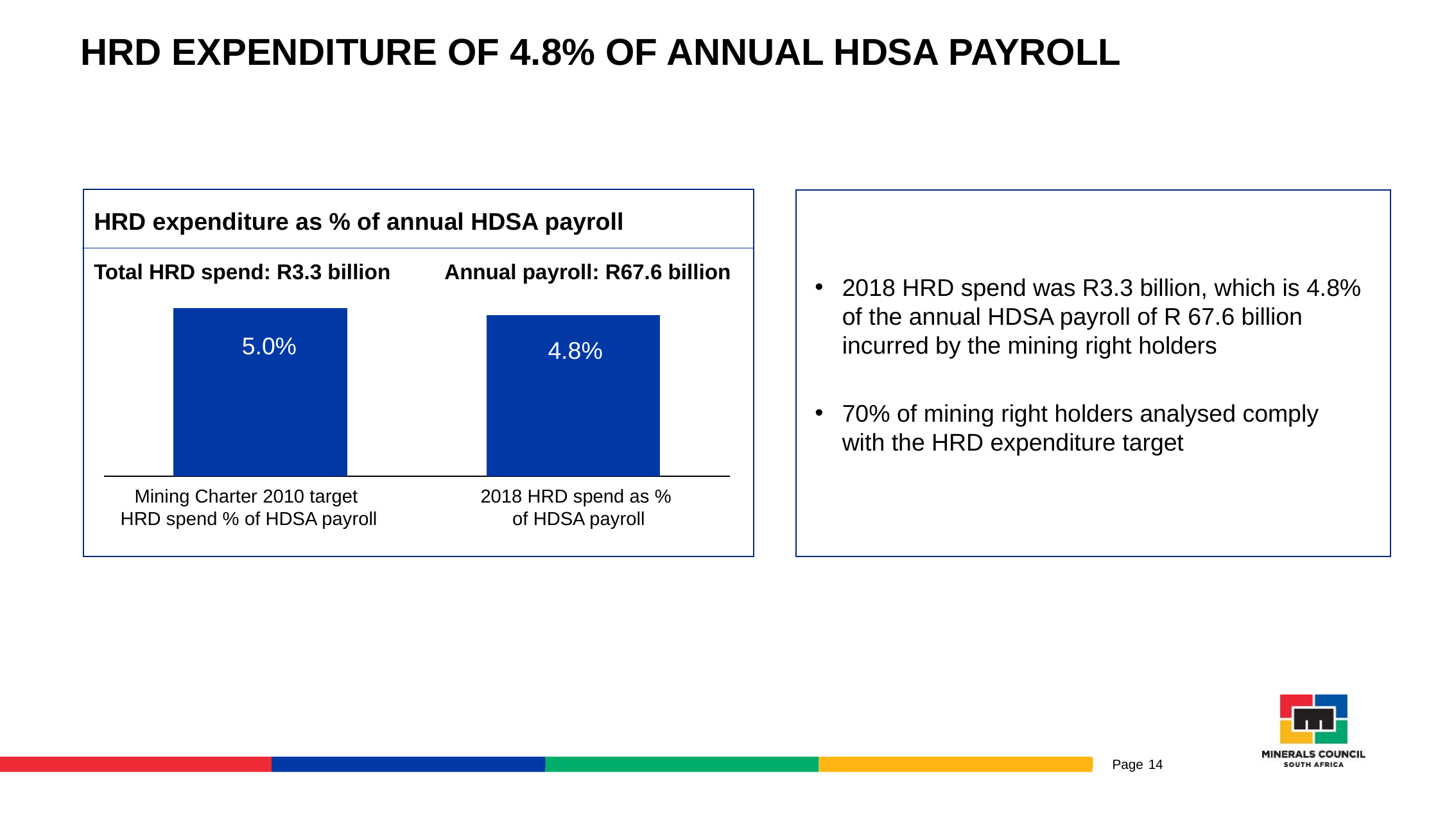
What total HRD spend is stated above the chart? R3.3 billion What is the difference between the Mining Charter 2010 target and the 2018 HRD spend as % of HDSA payroll? 0.2% Which category has the lowest value? 2018 HRD spend as % of HDSA payroll How many bars are shown in the chart? 2 What is the title of the chart? HRD expenditure as % of annual HDSA payroll Which category has the highest value? Mining Charter 2010 target HRD spend % of HDSA payroll Which is larger: the Mining Charter 2010 target or the 2018 HRD spend as % of HDSA payroll? Mining Charter 2010 target HRD spend % of HDSA payroll What is the value for 2018 HRD spend as % of HDSA payroll? 4.8% What is the value for Mining Charter 2010 target HRD spend % of HDSA payroll? 5.0% What kind of chart is shown on the slide? Bar chart